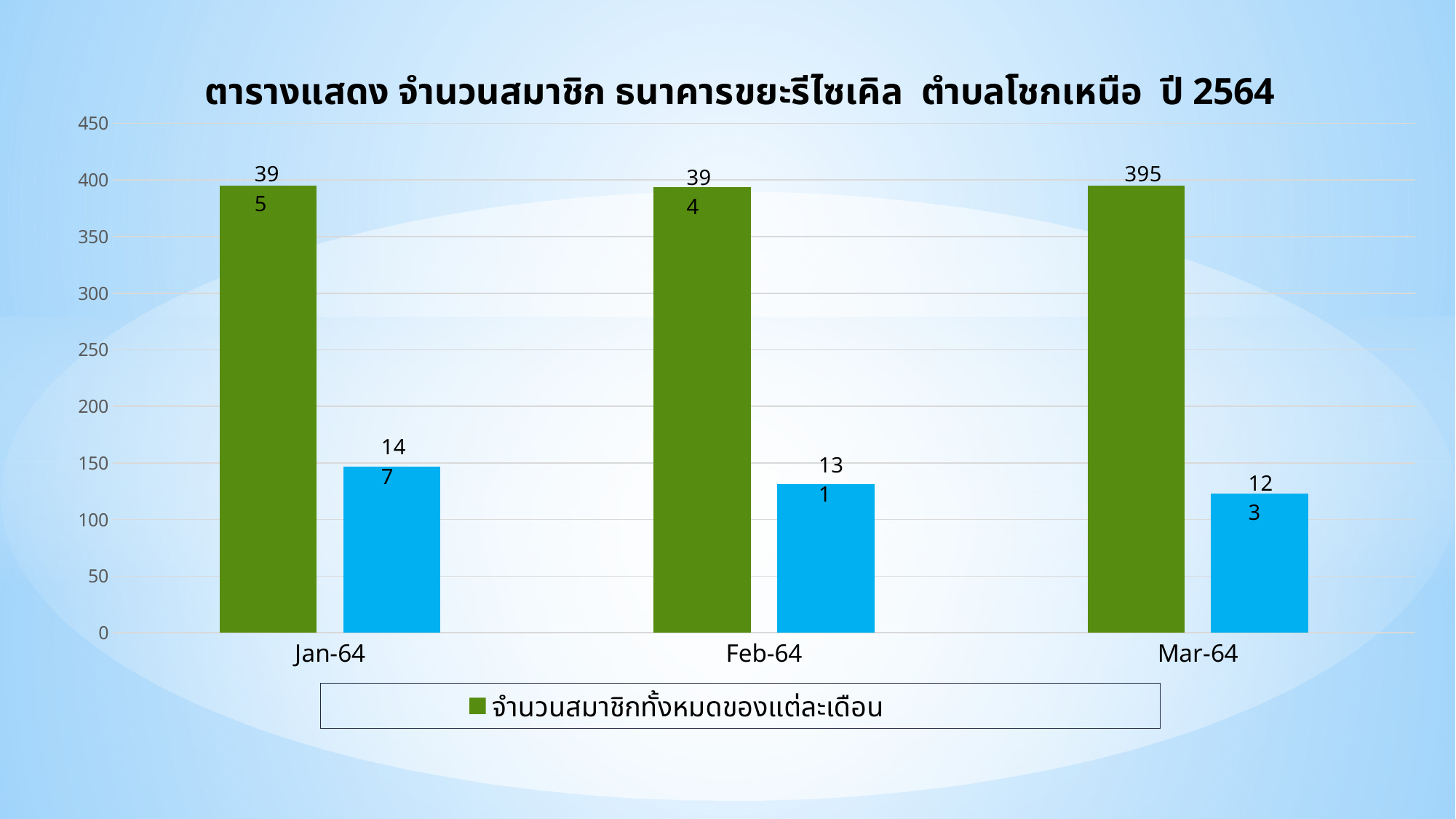
What is the value of the blue bar for Mar-64? 123 What is the difference between the blue bar values for Jan-64 and Mar-64? 24 What is the value of the green bar for Mar-64? 395 Do the blue bars rise or fall from Jan-64 to Mar-64? Fall What is the value of the blue bar for Jan-64? 147 How many months are shown on the x axis of the chart? 3 What is the value of the blue bar for Feb-64? 131 How many series does the chart's legend list? 1 Is the value of the green bar for Jan-64 greater or less than 350? greater Which month has the lowest blue bar? Mar-64 What kind of chart is shown on the slide? Bar chart Which month has the highest blue bar? Jan-64